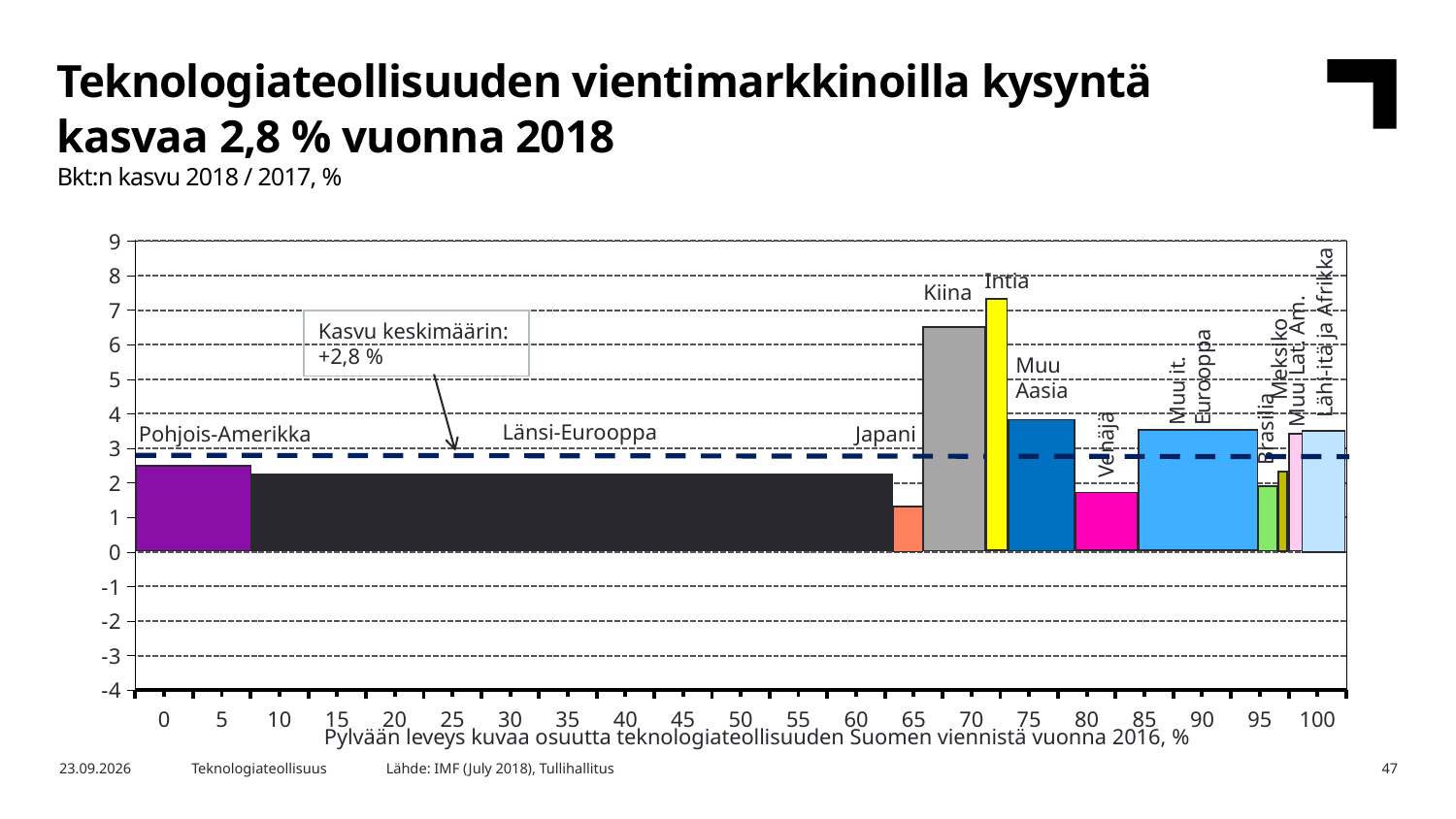
What kind of chart is shown on the slide? bar chart How many labeled categories (bars) are shown in the chart? 12 Is the value for Intia greater or less than 7? greater Which category has the highest GDP growth value in the chart? Intia Is the value for Japani greater or less than 2? less Which has the larger value, Kiina or Japani? Kiina Is the value for Kiina greater or less than 6? greater Which has the larger value, Pohjois-Amerikka or Länsi-Eurooppa? Pohjois-Amerikka Which category has the lowest GDP growth value in the chart? Japani According to the x-axis caption, what does the width of each bar represent? Osuutta teknologiateollisuuden Suomen viennistä vuonna 2016, % What average growth value is printed in the chart's annotation box? +2,8 %